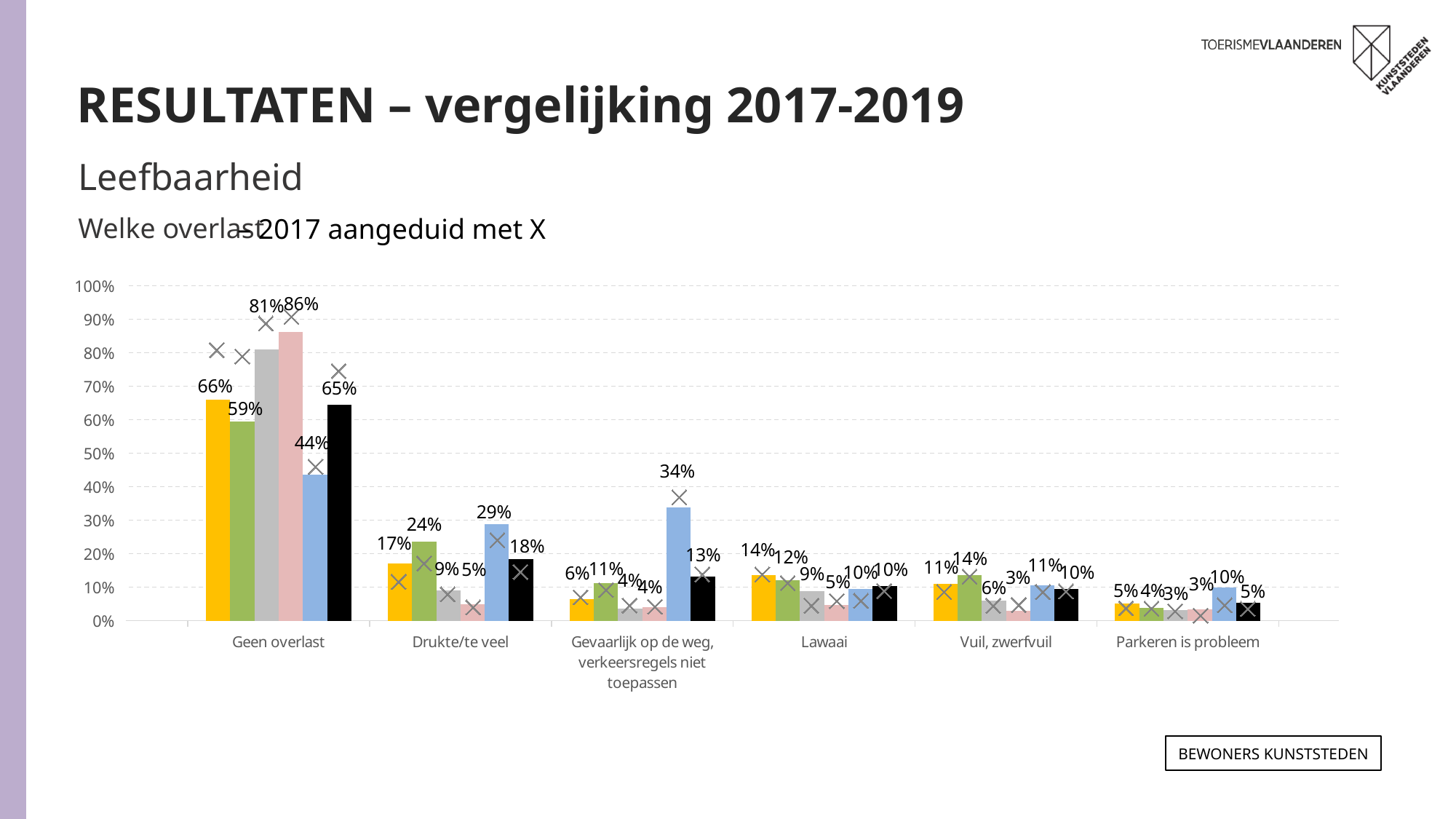
How many categories are shown along the x axis of the chart? 6 Is the 2017 X marker for the blue series in 'Gevaarlijk op de weg, verkeersregels niet toepassen' greater or less than 30%? greater What is the value of the blue bar for 'Gevaarlijk op de weg, verkeersregels niet toepassen'? 34% Within 'Geen overlast', which coloured bar has the lowest value? blue (44%) What is the difference between the pink bar (86%) and the yellow bar (66%) for 'Geen overlast'? 20% According to the subtitle, how are the 2017 values indicated on the chart? with an X What is the value of the yellow bar for 'Lawaai'? 14% What is the value of the green bar for 'Drukte/te veel'? 24% For 'Drukte/te veel', which is larger: the blue bar or the black bar? blue bar What kind of chart is shown on the slide? bar chart What is the value of the pink bar for 'Geen overlast'? 86% Which category has the highest value for the blue bar? Geen overlast